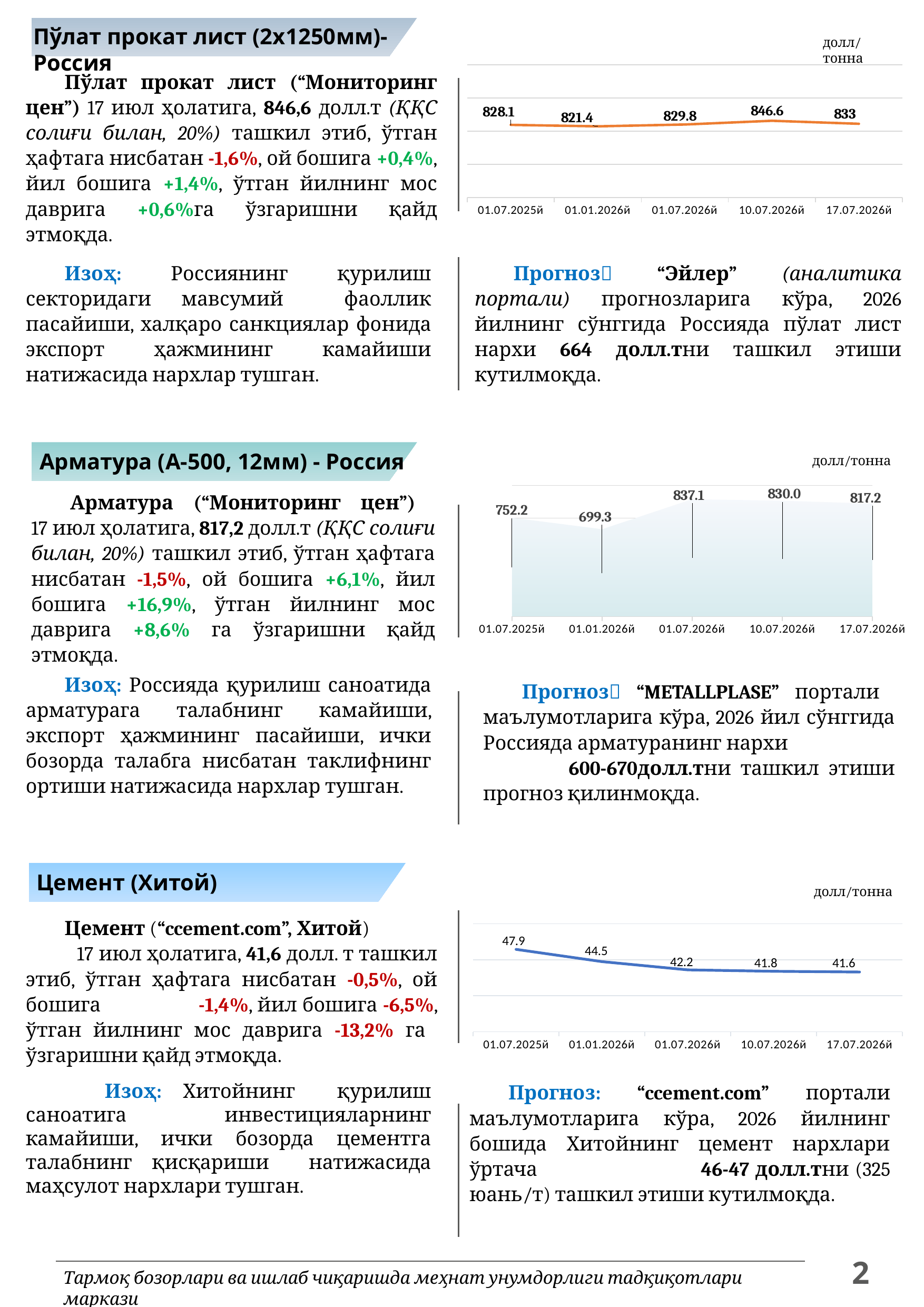
In the middle chart (rebar), which is larger: the value for 01.07.2025й or the value for 17.07.2026й? 17.07.2026й In the top chart (steel sheet), which date has the highest value? 10.07.2026й In the middle chart (rebar), which date has the highest value? 01.07.2026й In the bottom chart (cement), what is the difference between the values for 01.07.2025й and 17.07.2026й? 6.3 In the middle chart (rebar, Арматура), what is the value for 01.01.2026й? 699.3 In the bottom chart (cement), do the values rise or fall from 01.07.2025й to 17.07.2026й? fall In the middle chart (rebar), which date has the lowest value? 01.01.2026й What kind of chart is the bottom chart (cement)? line chart In the top chart (steel sheet), how many data points are plotted? 5 In the top chart (steel sheet, Пўлат прокат лист), what is the value for 17.07.2026й? 833 In the bottom chart (cement, Цемент), what is the value for 01.07.2025й? 47.9 In the top chart (steel sheet), what is the difference between the values for 10.07.2026й and 17.07.2026й? 13.6